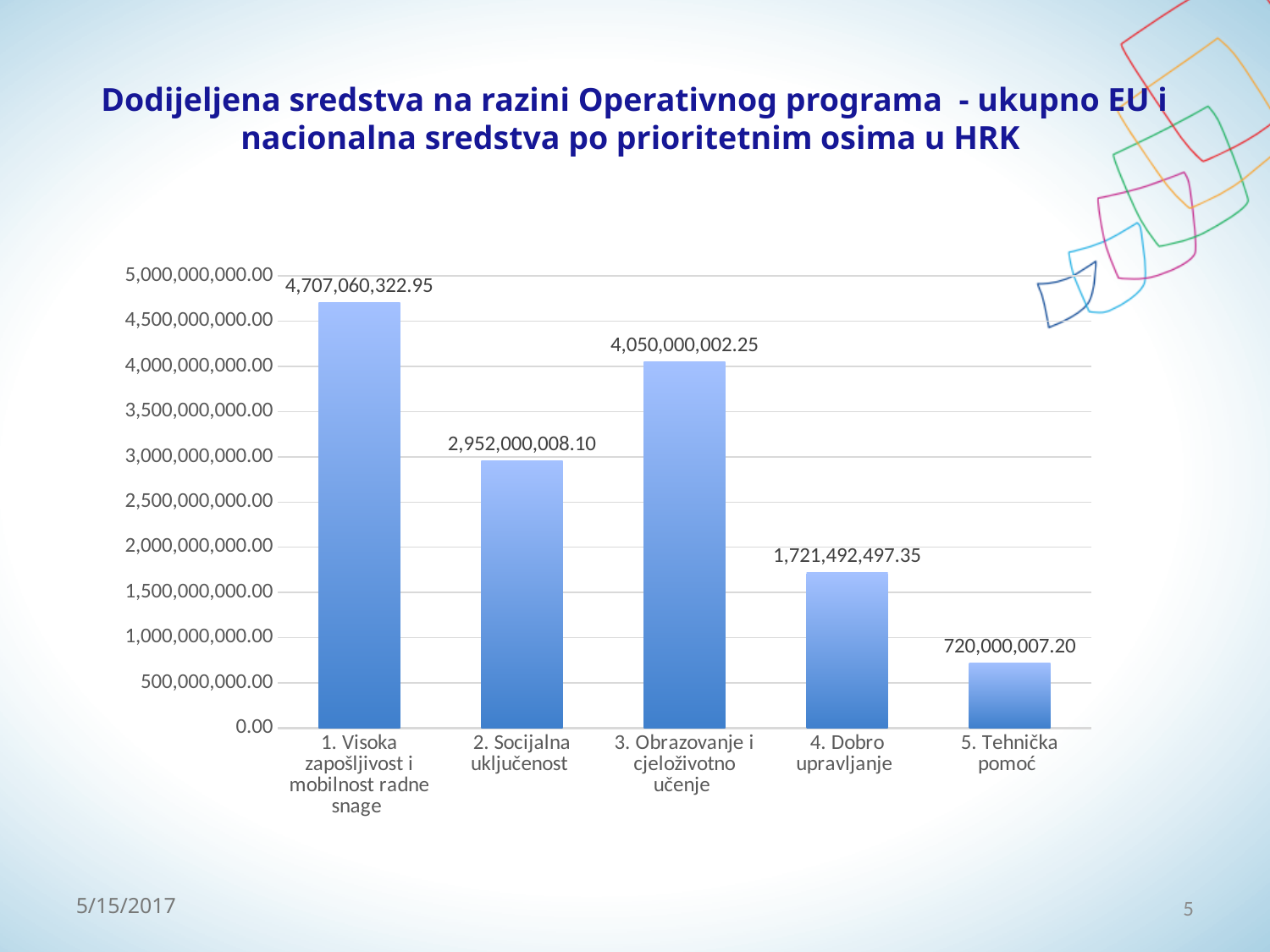
What is the difference between the values for "1. Visoka zapošljivost i mobilnost radne snage" and "3. Obrazovanje i cjeloživotno učenje"? 657,060,320.70 What is the difference between the values for "4. Dobro upravljanje" and "5. Tehnička pomoć"? 1,001,492,490.15 Which is larger, the value for "2. Socijalna uključenost" or the value for "3. Obrazovanje i cjeloživotno učenje"? 3. Obrazovanje i cjeloživotno učenje What is the value for "2. Socijalna uključenost"? 2,952,000,008.10 What is the value for "4. Dobro upravljanje"? 1,721,492,497.35 What is the value for "3. Obrazovanje i cjeloživotno učenje"? 4,050,000,002.25 What kind of chart is shown on the slide? Bar chart Which category has the highest value? 1. Visoka zapošljivost i mobilnost radne snage Which category has the lowest value? 5. Tehnička pomoć What is the value for "1. Visoka zapošljivost i mobilnost radne snage"? 4,707,060,322.95 What is the value for "5. Tehnička pomoć"? 720,000,007.20 How many categories are shown on the x axis? 5